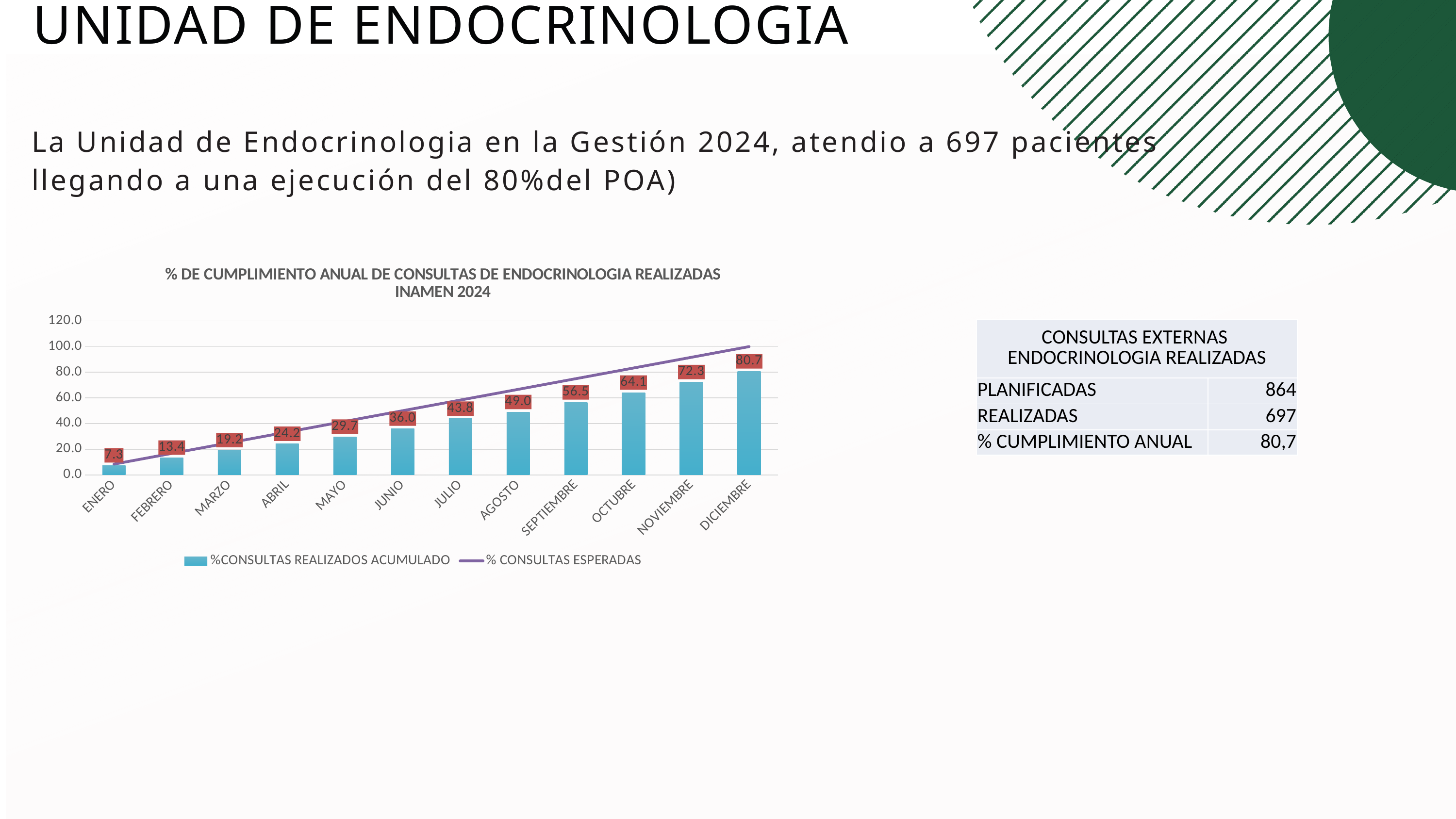
Which month has the highest %CONSULTAS REALIZADOS ACUMULADO bar? DICIEMBRE What is the value of %CONSULTAS REALIZADOS ACUMULADO for ENERO? 7.3 How many series does the chart legend list? 2 What is the difference between the %CONSULTAS REALIZADOS ACUMULADO values for DICIEMBRE and NOVIEMBRE? 8.4 What is the value of %CONSULTAS REALIZADOS ACUMULADO for JUNIO? 36.0 What is the value of %CONSULTAS REALIZADOS ACUMULADO for DICIEMBRE? 80.7 Is the % CONSULTAS ESPERADAS line value for DICIEMBRE greater or less than 80.0? greater Do the %CONSULTAS REALIZADOS ACUMULADO bars rise or fall from ENERO to DICIEMBRE? rise How many months are shown on the x axis of the chart? 12 Which is larger, the %CONSULTAS REALIZADOS ACUMULADO value for JULIO or for AGOSTO? AGOSTO What is the value of %CONSULTAS REALIZADOS ACUMULADO for SEPTIEMBRE? 56.5 Which month has the lowest %CONSULTAS REALIZADOS ACUMULADO bar? ENERO